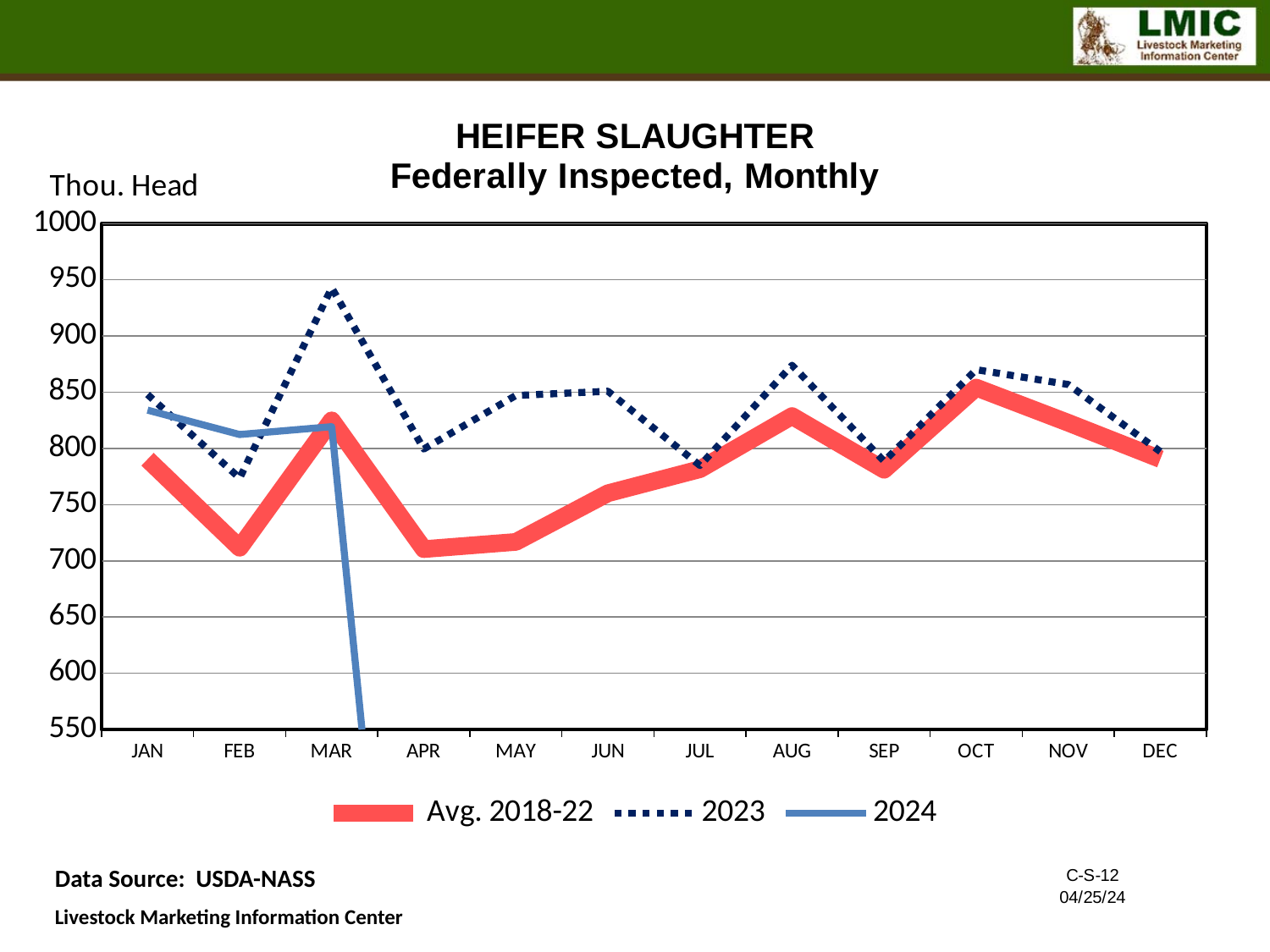
Is the Avg. 2018-22 value for APR greater or less than 750? less How many months are shown along the x axis? 12 Does the Avg. 2018-22 series rise or fall from APR to OCT? rise What kind of chart is shown on the slide? line chart In MAR, which is larger: the 2023 value or the Avg. 2018-22 value? 2023 Is the 2023 value for MAR greater or less than 900? greater How many series does the legend list? 3 Is the 2024 value for JAN greater or less than 800? greater What unit is shown on the y axis label? Thou. Head In which month does the 2023 series reach its highest value? MAR In which month does the Avg. 2018-22 series reach its highest value? OCT